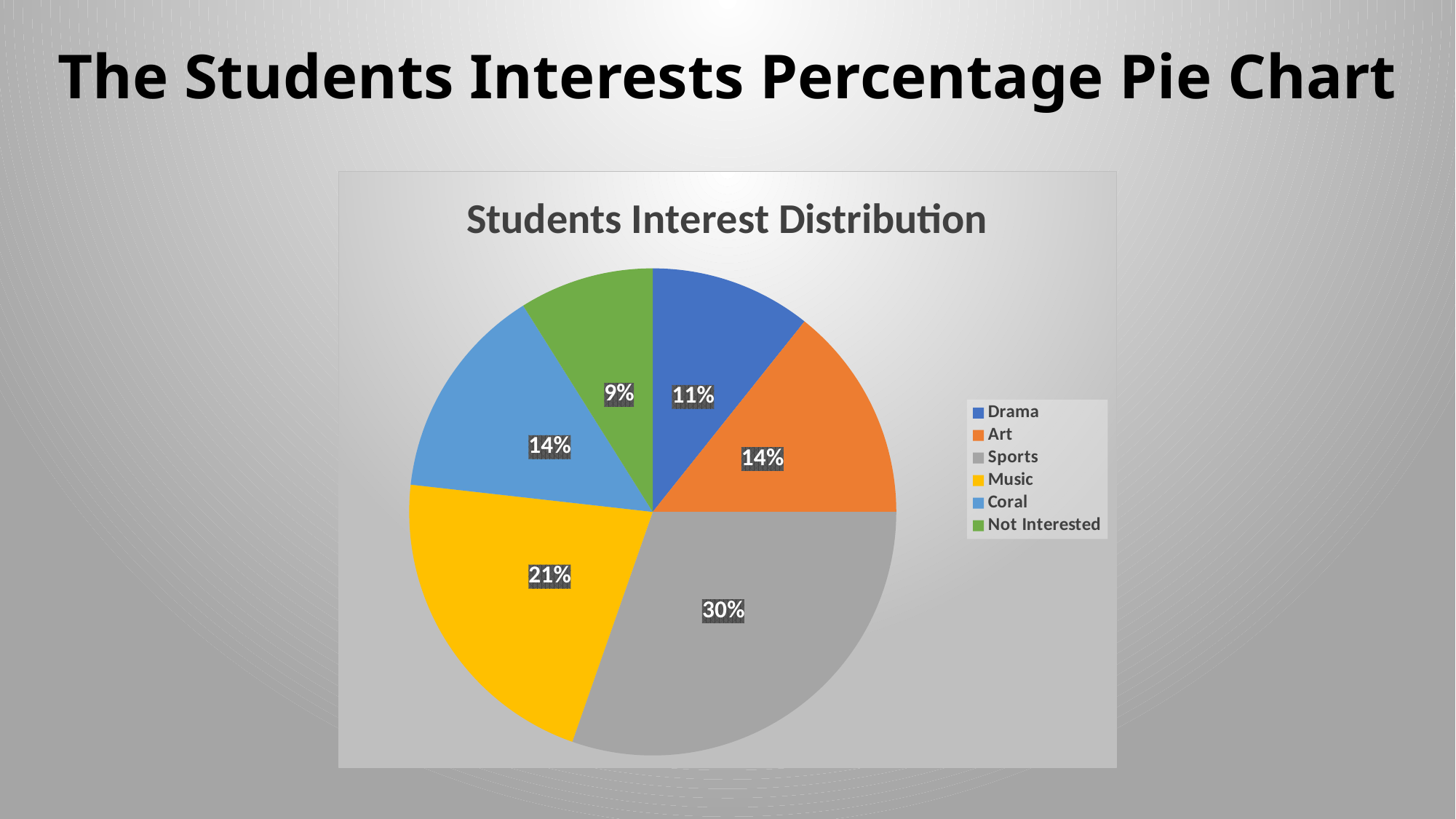
Which category has the smallest share of the pie? Not Interested Which colour represents Coral in the pie chart? Light blue What kind of chart is shown on the slide? Pie chart What is the difference in percentage points between Sports and Music? 9 Which has a larger share, Drama or Music? Music Which interest category has the largest share of the pie? Sports What percentage of students are interested in Music? 21% What percentage of students are interested in Sports? 30% What is the title of the chart? Students Interest Distribution What percentage of students are interested in Drama? 11% What percentage of students are Not Interested? 9% How many categories does the pie chart show? 6